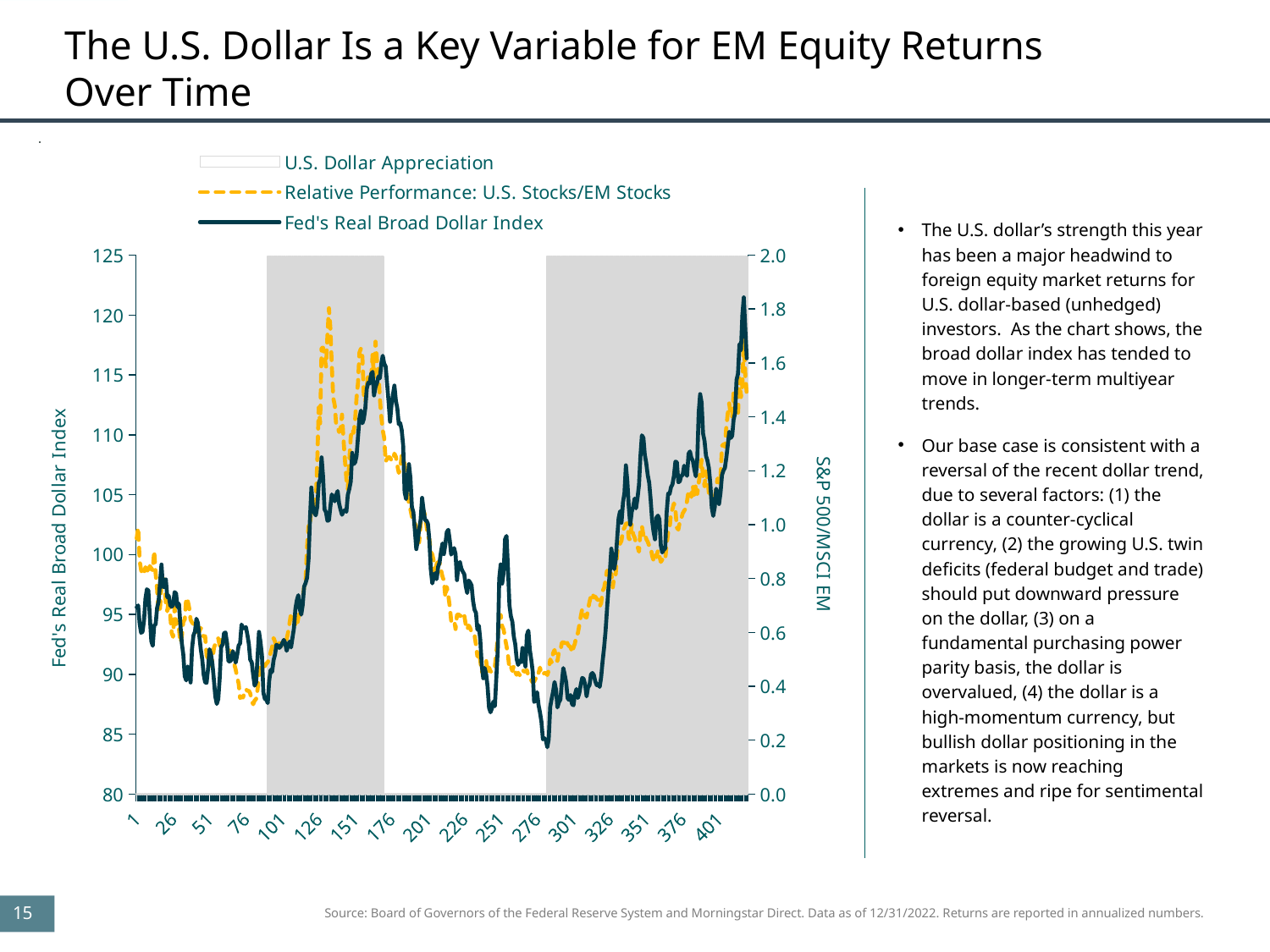
Is the Fed's Real Broad Dollar Index higher at its peak near x = 176 or at its peak near x = 401? near x = 401 What is the title of the left vertical axis? Fed's Real Broad Dollar Index Does the Fed's Real Broad Dollar Index rise or fall between x = 176 and x = 276? fall Does the Fed's Real Broad Dollar Index rise or fall between x = 101 and x = 151? rise What is the title of the right vertical axis? S&P 500/MSCI EM Is the value of the Fed's Real Broad Dollar Index at x = 1 greater or less than 90? greater What kind of chart is shown on the slide? Combination bar and line chart How many shaded U.S. Dollar Appreciation periods are shown on the chart? 2 Is the value of the Fed's Real Broad Dollar Index at x = 276 greater or less than 90? less Is the peak of the Relative Performance: U.S. Stocks/EM Stocks line near x = 126 greater or less than 1.6? greater What is the highest value shown on the left vertical axis? 125 How many series does the chart's legend list? 3